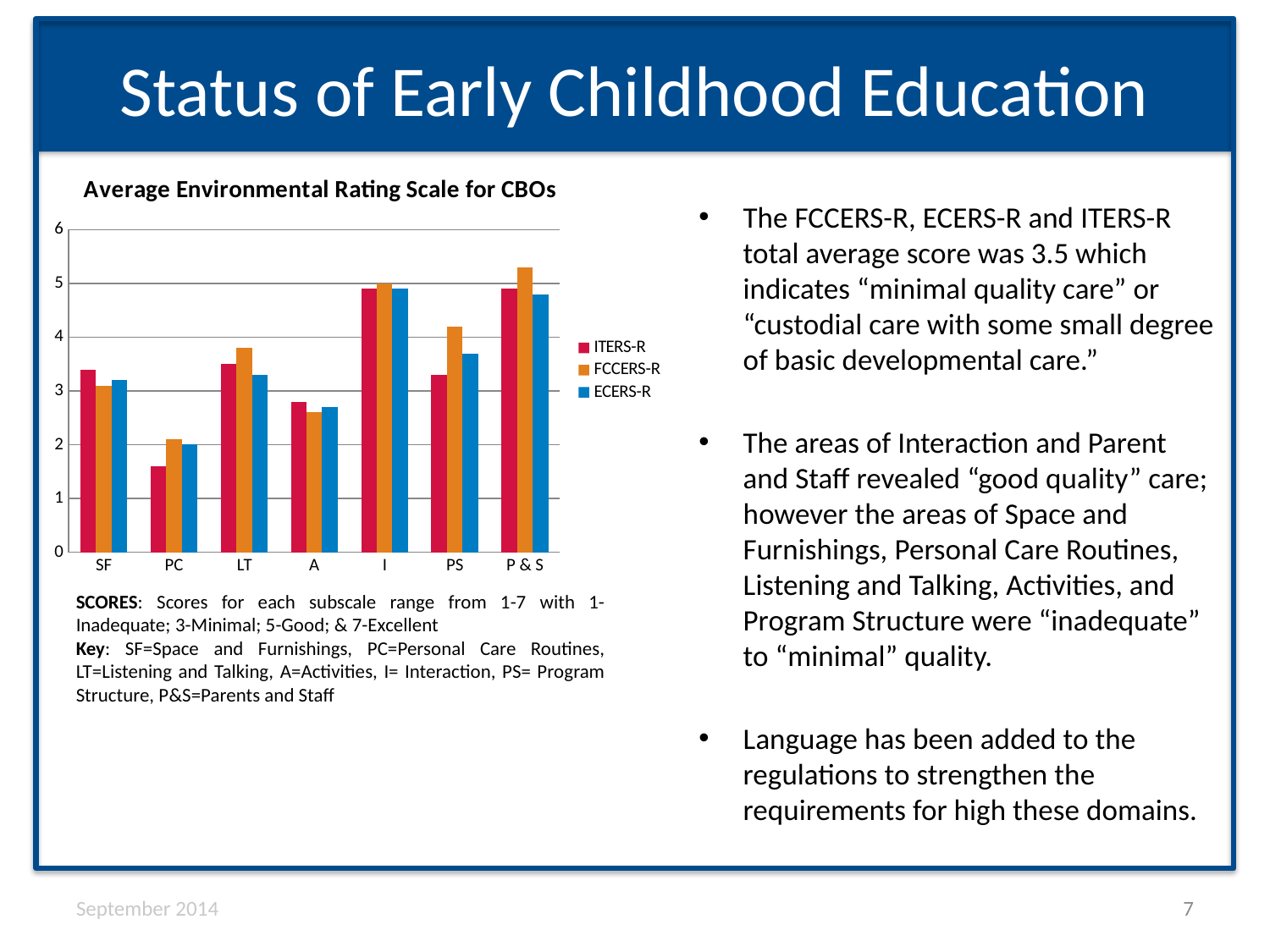
What is the title of the chart? Average Environmental Rating Scale for CBOs Is the FCCERS-R value for PS greater or less than 4? greater Which colour represents the ECERS-R series in the chart? Blue Which category has the lowest ITERS-R value? PC Is the ITERS-R value for PC greater or less than 2? less What kind of chart is shown on the slide? Bar chart How many series does the chart's legend list? 3 For the PC category, which is larger: the ITERS-R value or the FCCERS-R value? FCCERS-R For the PS category, which is larger: the FCCERS-R value or the ECERS-R value? FCCERS-R Is the ECERS-R value for A greater or less than 3? less How many categories are shown on the x axis of the chart? 7 Which category has the highest FCCERS-R value? P & S